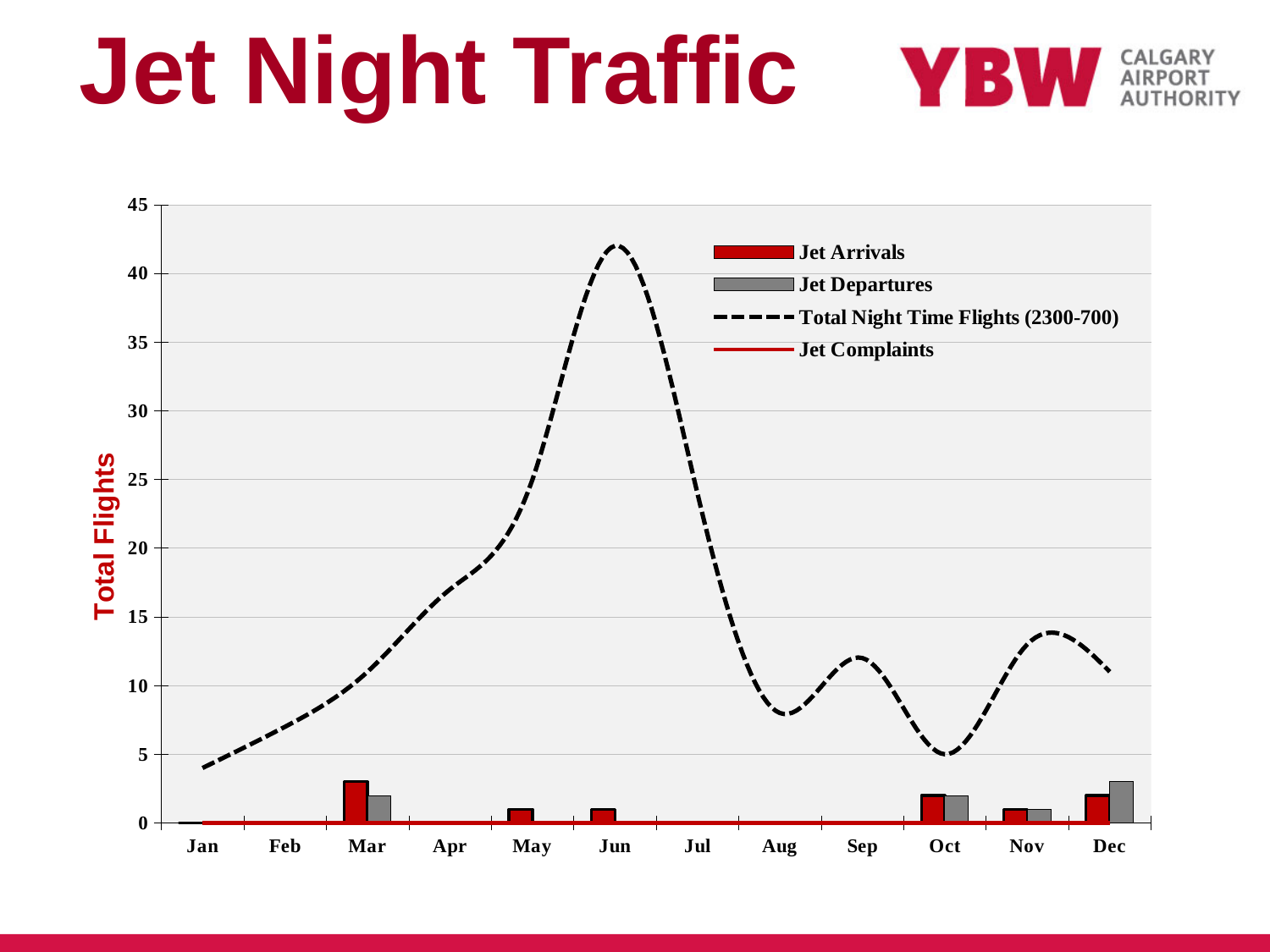
What kind of chart is shown on the slide? Combined bar and line chart How many series does the legend list? 4 What is the title of the y axis? Total Flights Does Total Night Time Flights (2300-700) rise or fall from Jan to Jun? Rise Which is larger, Total Night Time Flights (2300-700) in Jun or in Aug? Jun In which month is Total Night Time Flights (2300-700) highest? Jun In Mar, which is larger, Jet Arrivals or Jet Departures? Jet Arrivals Is the value of Total Night Time Flights (2300-700) in Jan greater or less than 5? less In which month is Total Night Time Flights (2300-700) lowest? Jan Is the value of Total Night Time Flights (2300-700) in Jun greater or less than 40? greater How many months are shown on the x axis? 12 Is the value of Total Night Time Flights (2300-700) in Aug greater or less than 10? less